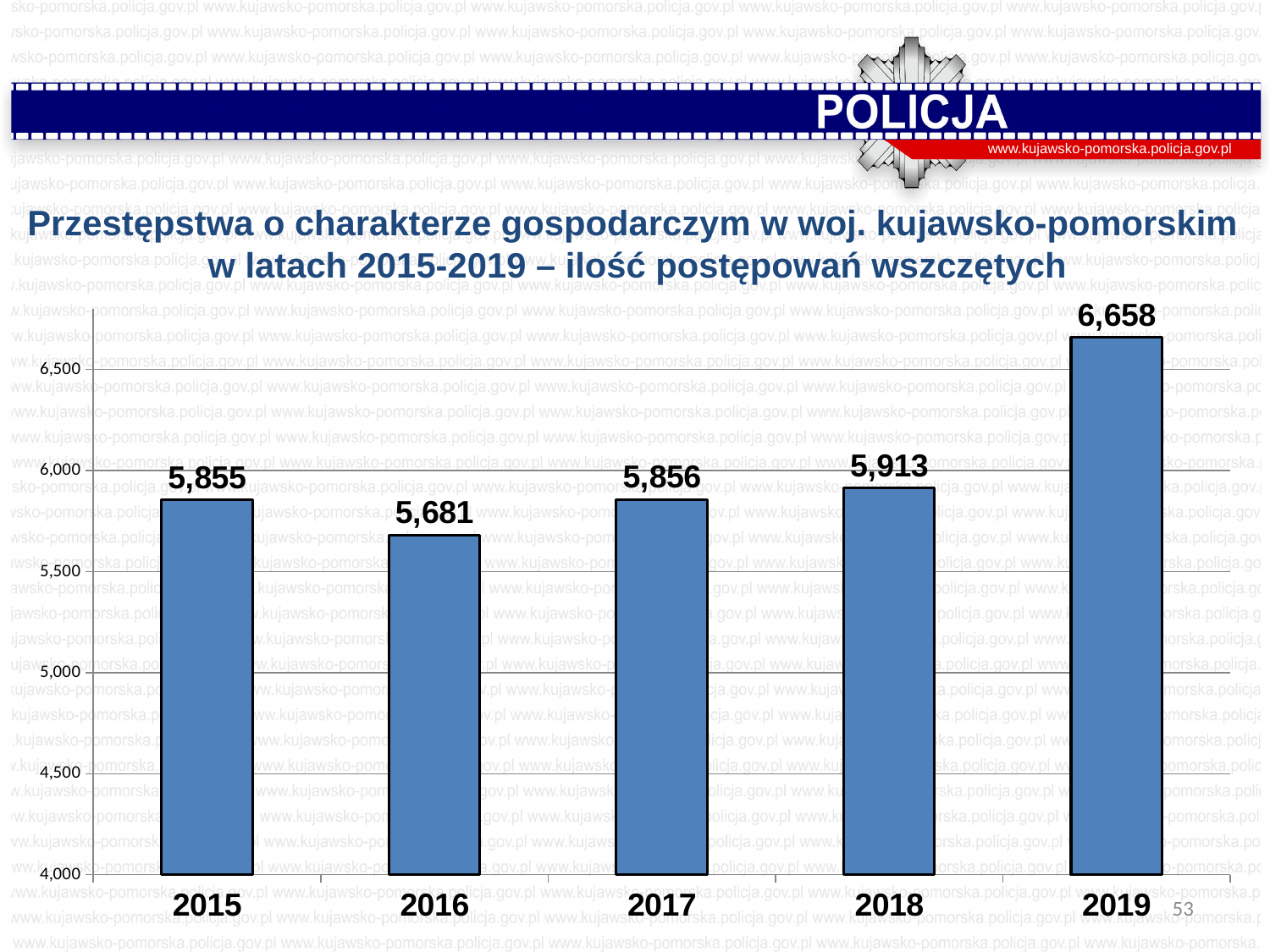
Is the value for 2019 greater or less than 6,500? greater What is the value for 2016? 5,681 Which year has the lowest value? 2016 Which is larger, the value for 2018 or the value for 2016? 2018 What is the value for 2015? 5,855 What kind of chart is shown on the slide? bar chart What is the value for 2017? 5,856 What is the value for 2019? 6,658 How many years are shown on the chart? 5 Which year has the highest value? 2019 What is the value for 2018? 5,913 What is the difference between the values for 2019 and 2018? 745